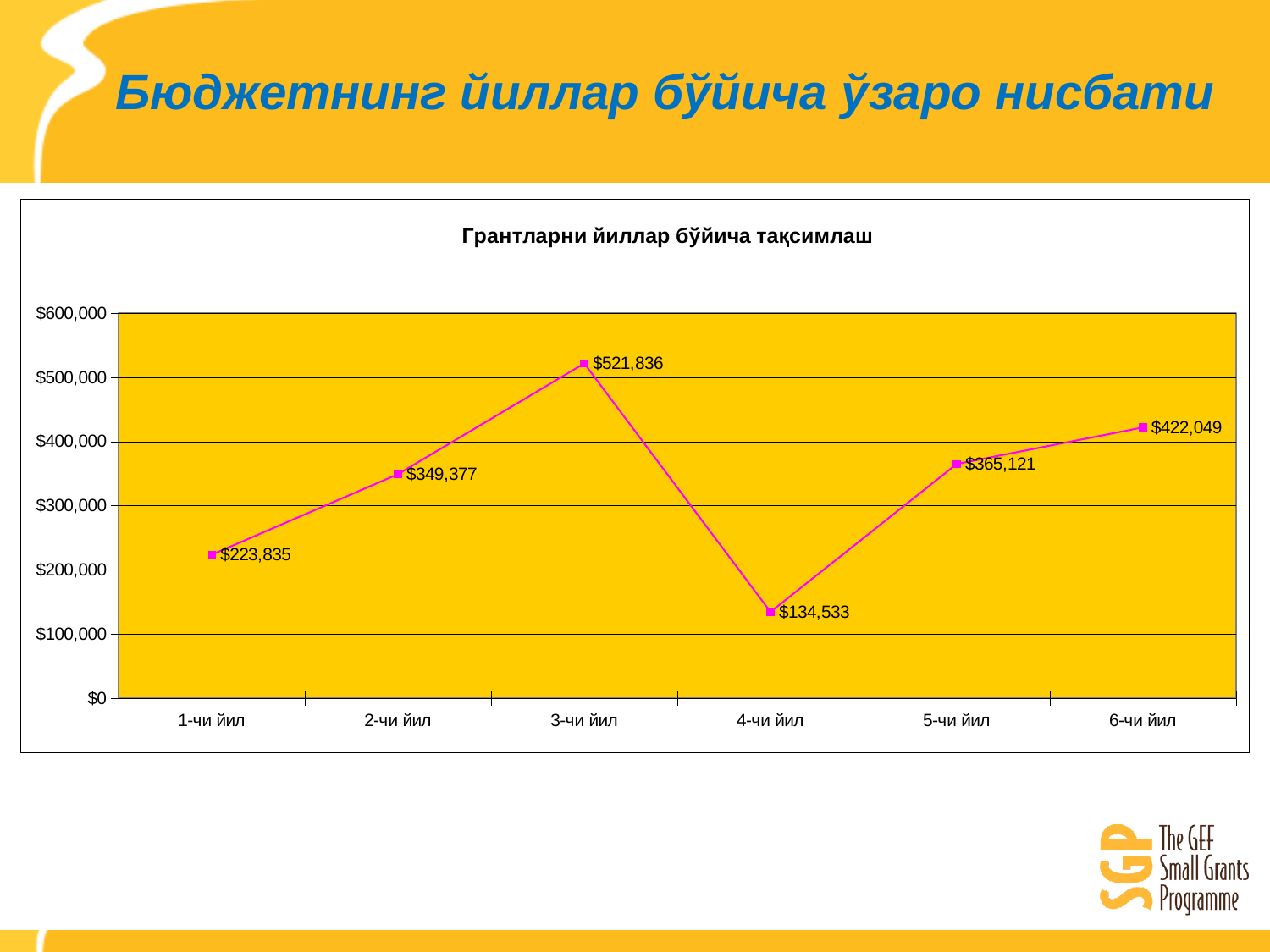
Which year has the lowest value? 4-чи йил What is the value for 1-чи йил? $223,835 What is the value for 3-чи йил? $521,836 Which year has the highest value? 3-чи йил What is the difference between the values for 6-чи йил and 5-чи йил? $56,928 Which is larger, the value for 2-чи йил or the value for 5-чи йил? 5-чи йил Is the value for 4-чи йил greater or less than $200,000? less What is the difference between the values for 3-чи йил and 4-чи йил? $387,303 What is the title of the chart? Грантларни йиллар бўйича тақсимлаш What is the value for 6-чи йил? $422,049 What kind of chart is shown? line chart How many years are plotted on the chart? 6